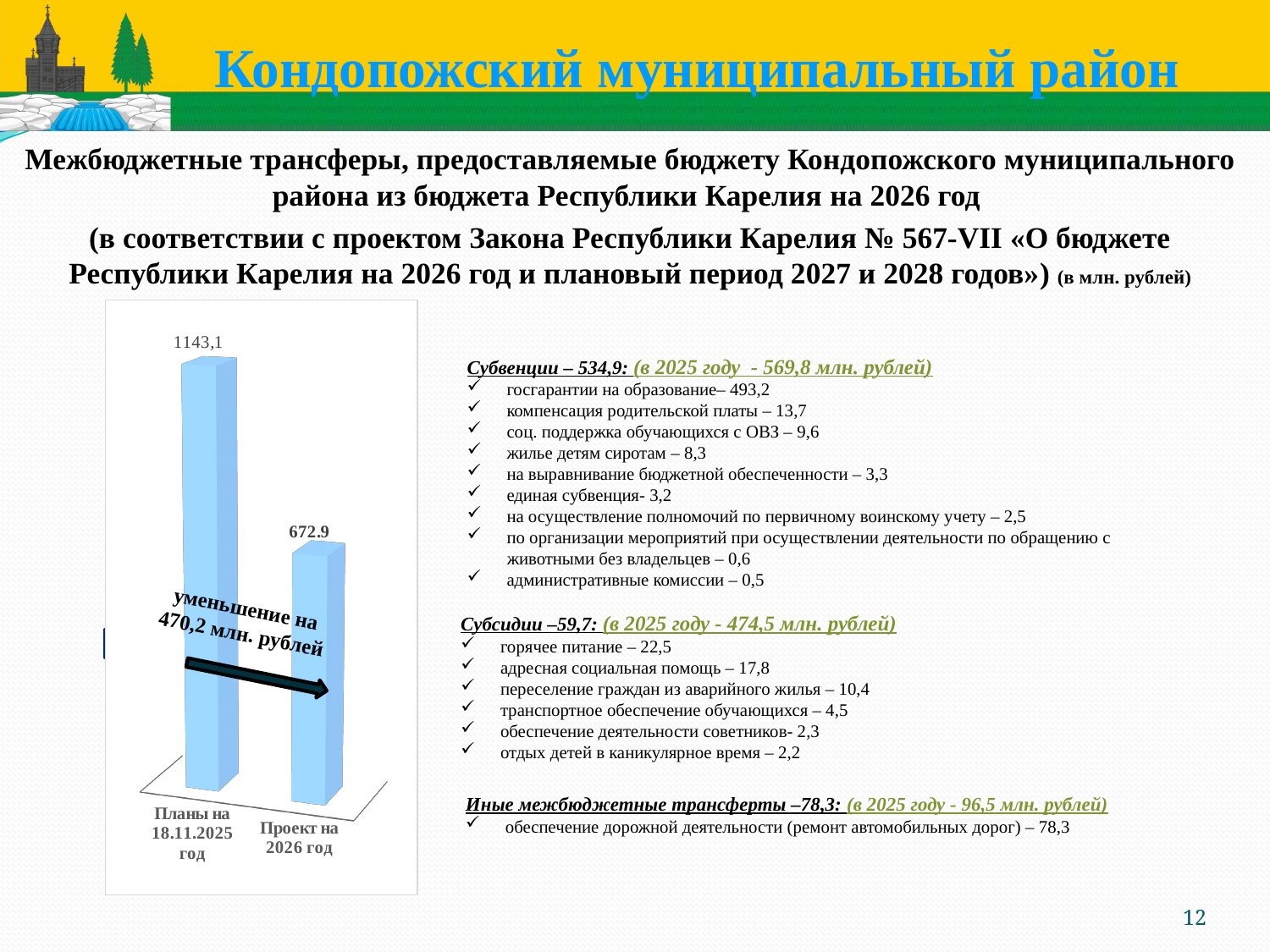
Which category has the lowest value in the bar chart? Проект на 2026 год What is the value for 'Проект на 2026 год' in the bar chart? 672.9 What colour are the bars in the chart? Light blue Which category has the highest value in the bar chart? Планы на 18.11.2025 год What is the difference between the value for 'Планы на 18.11.2025 год' and the value for 'Проект на 2026 год'? 470,2 Which is larger: the value for 'Планы на 18.11.2025 год' or the value for 'Проект на 2026 год'? Планы на 18.11.2025 год How many bars are shown in the chart? 2 What is the value for 'Планы на 18.11.2025 год' in the bar chart? 1143,1 What kind of chart is shown on the slide? Bar chart What decrease does the annotation on the chart state? уменьшение на 470,2 млн. рублей Do the values rise or fall from 'Планы на 18.11.2025 год' to 'Проект на 2026 год'? Fall